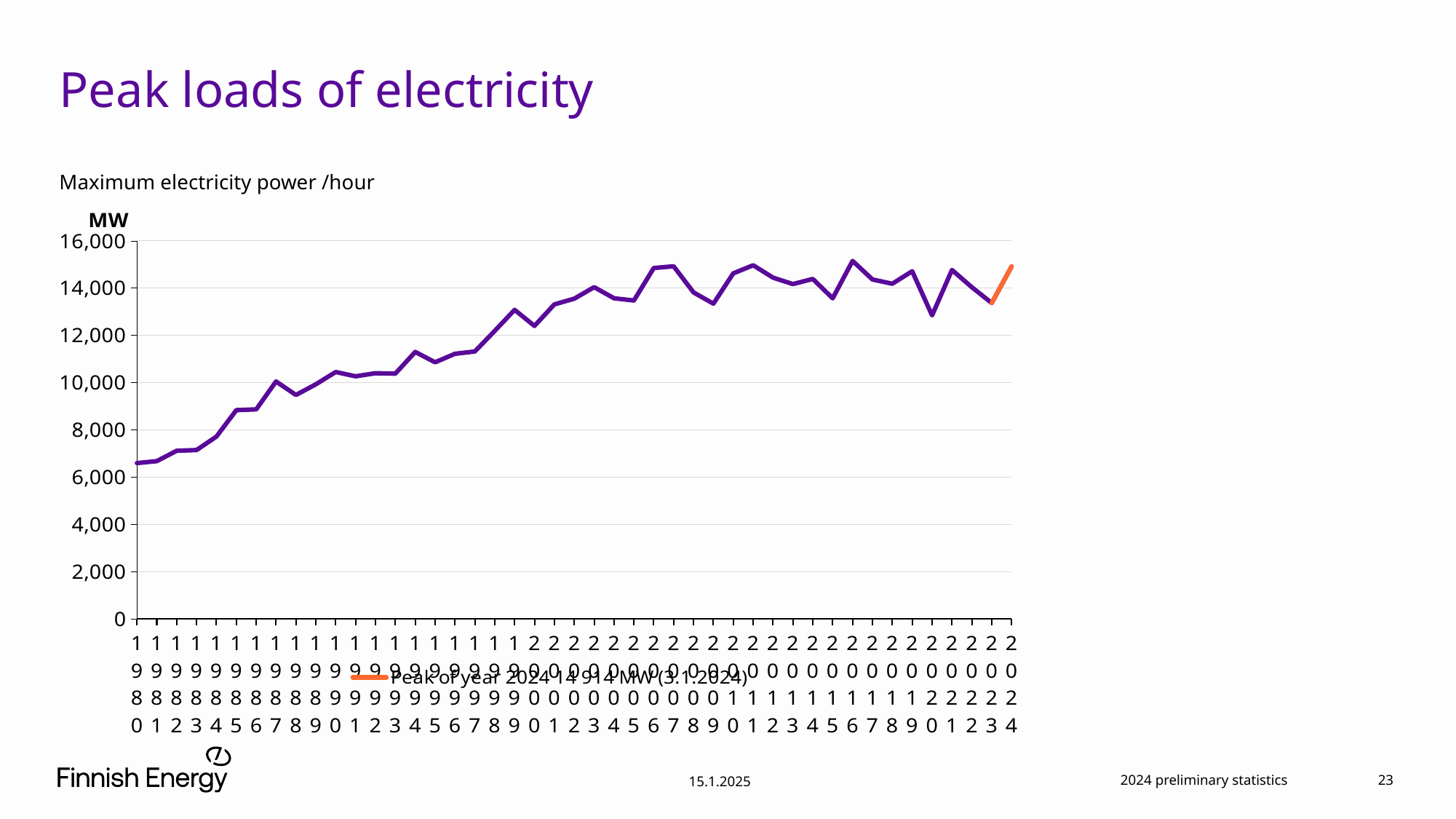
What kind of chart is shown on the slide? line chart Is the peak load for 1980 greater or less than 8,000 MW? less Is the peak load for 2000 greater or less than 12,000 MW? greater How many years are plotted on the x axis of the chart? 45 What was the peak load of electricity in 2024 according to the legend? 14 914 MW Is the peak load for 1995 greater or less than 10,000 MW? greater Which year has the larger peak load, 1990 or 2000? 2000 On what date did the 2024 peak of year occur, according to the legend? 3.1.2024 Does the peak load generally rise or fall from 1980 to 2024? rise Which year has the lowest peak load on the chart? 1980 What unit is shown on the y axis of the chart? MW